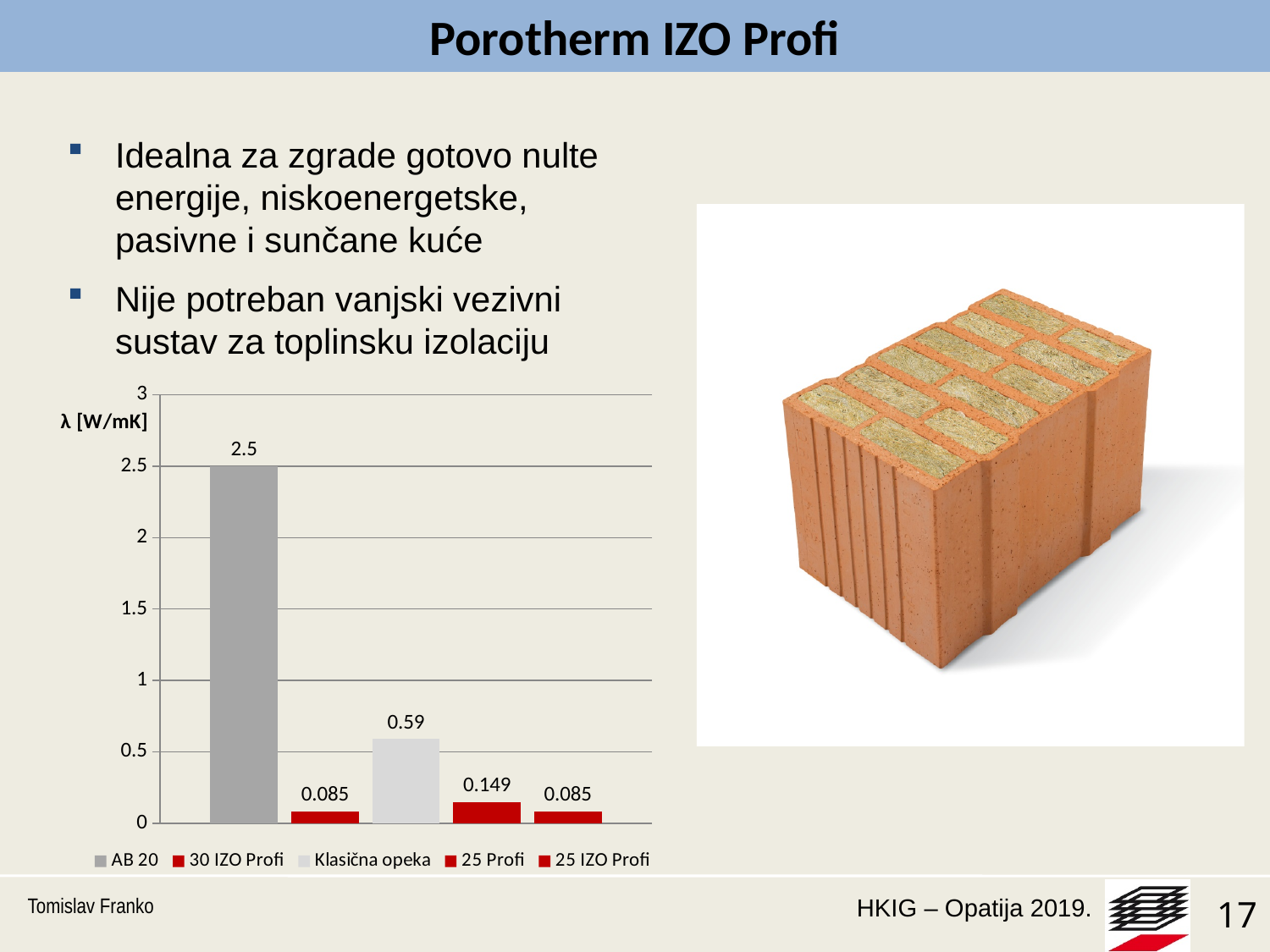
What is the λ value for 30 IZO Profi? 0.085 What is the difference between the λ values of 25 Profi and 25 IZO Profi? 0.064 What kind of chart is shown on the slide? bar chart What is the difference between the λ values of AB 20 and Klasična opeka? 1.91 What is the label on the vertical axis of the chart? λ [W/mK] Which series has the highest λ value? AB 20 What is the λ value for AB 20? 2.5 How many series does the legend list? 5 What is the λ value for 25 Profi? 0.149 What is the λ value for Klasična opeka? 0.59 Which has a larger λ value, Klasična opeka or 25 Profi? Klasična opeka Is the value for Klasična opeka greater or less than 1? less